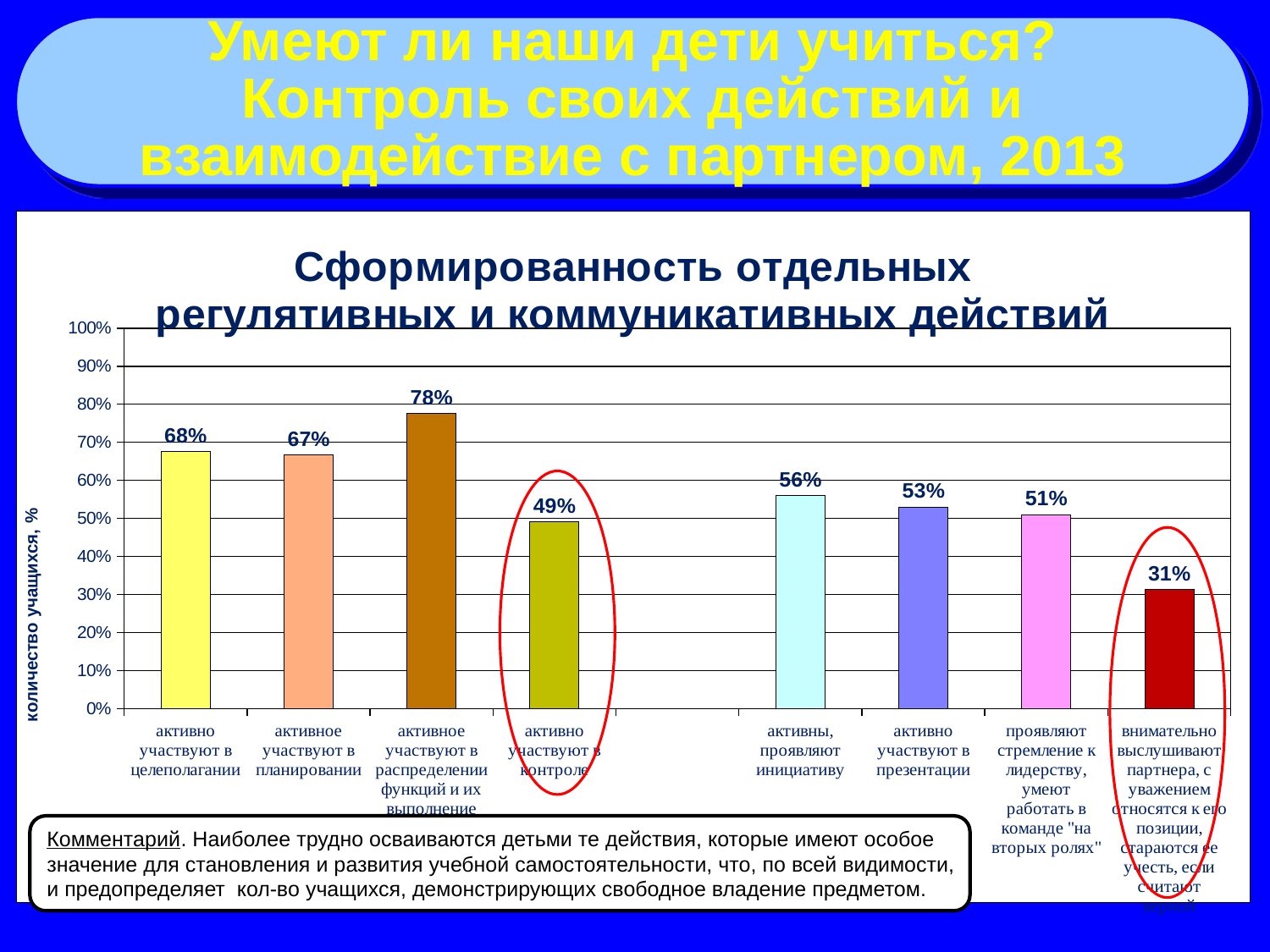
What is the title of the chart? Сформированность отдельных регулятивных и коммуникативных действий What is the value for the category "активно участвуют в контроле"? 49% What is the value for the category "активно участвуют в целеполагании"? 68% Which category has the highest value? активное участвуют в распределении функций и их выполнение Which category has the lowest value? внимательно выслушивают партнера, с уважением относятся к его позиции, стараются ее учесть, если считают верной What is the value for the category "активны, проявляют инициативу"? 56% Which is larger: the value for "активное участвуют в планировании" or the value for "проявляют стремление к лидерству, умеют работать в команде"? активное участвуют в планировании What type of chart is shown on the slide? bar chart What is the difference between the highest value (78%) and the lowest value (31%)? 47% What is the label of the vertical axis? количество учащихся, % How many bars are plotted in the chart? 8 What is the value for the category "активно участвуют в презентации"? 53%